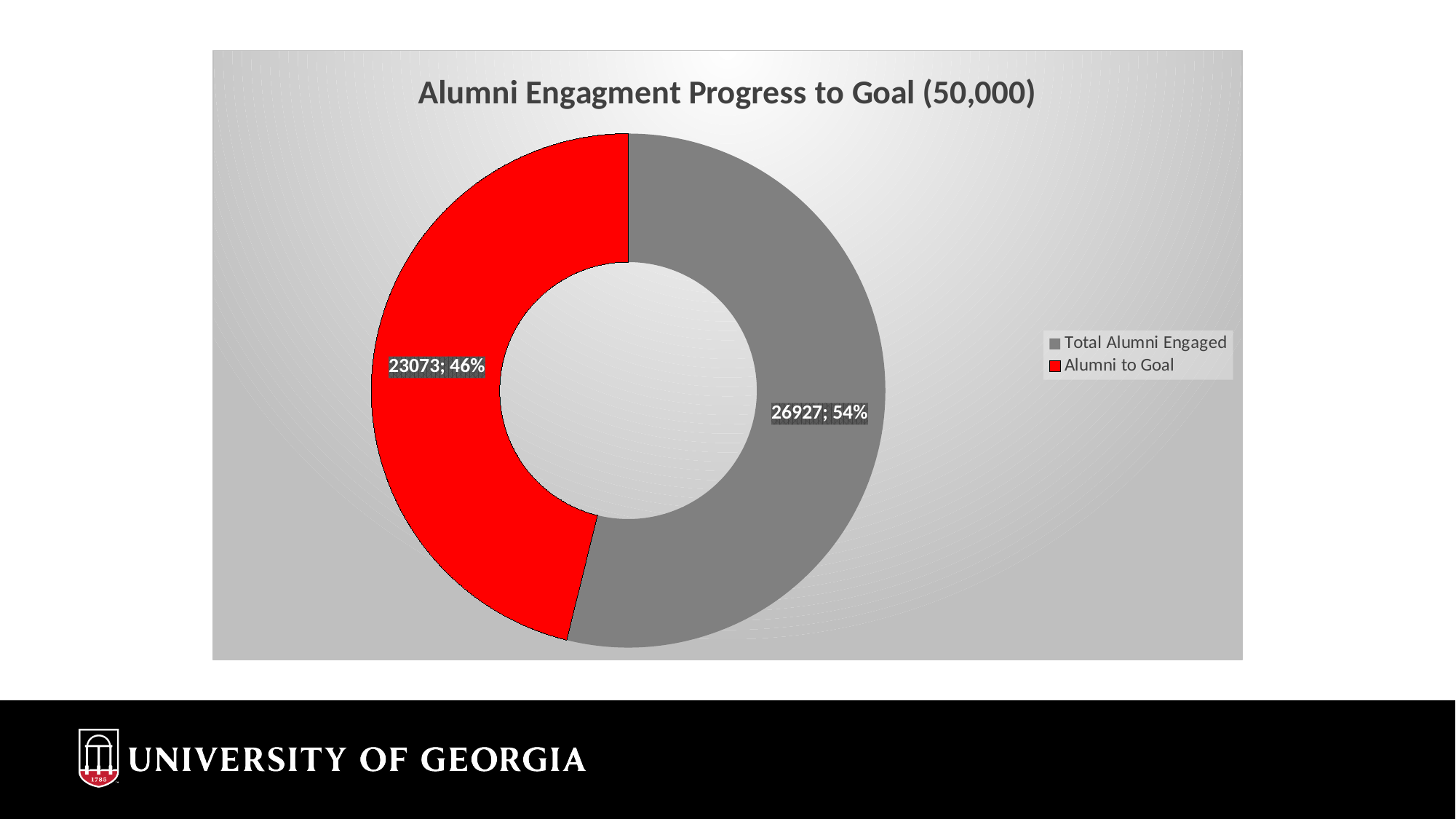
What is the value for Total Alumni Engaged? 26927 What kind of chart is shown on the slide? doughnut chart What colour represents Alumni to Goal in the chart? red Which category has the larger value? Total Alumni Engaged What share of the chart does Total Alumni Engaged represent? 54% What is the value for Alumni to Goal? 23073 What is the difference between Total Alumni Engaged and Alumni to Goal? 3854 Which category has the smaller value? Alumni to Goal Is the value for Total Alumni Engaged larger or smaller than the value for Alumni to Goal? larger What share of the chart does Alumni to Goal represent? 46% How many categories are shown in the chart? 2 What is the title of the chart? Alumni Engagment Progress to Goal (50,000)